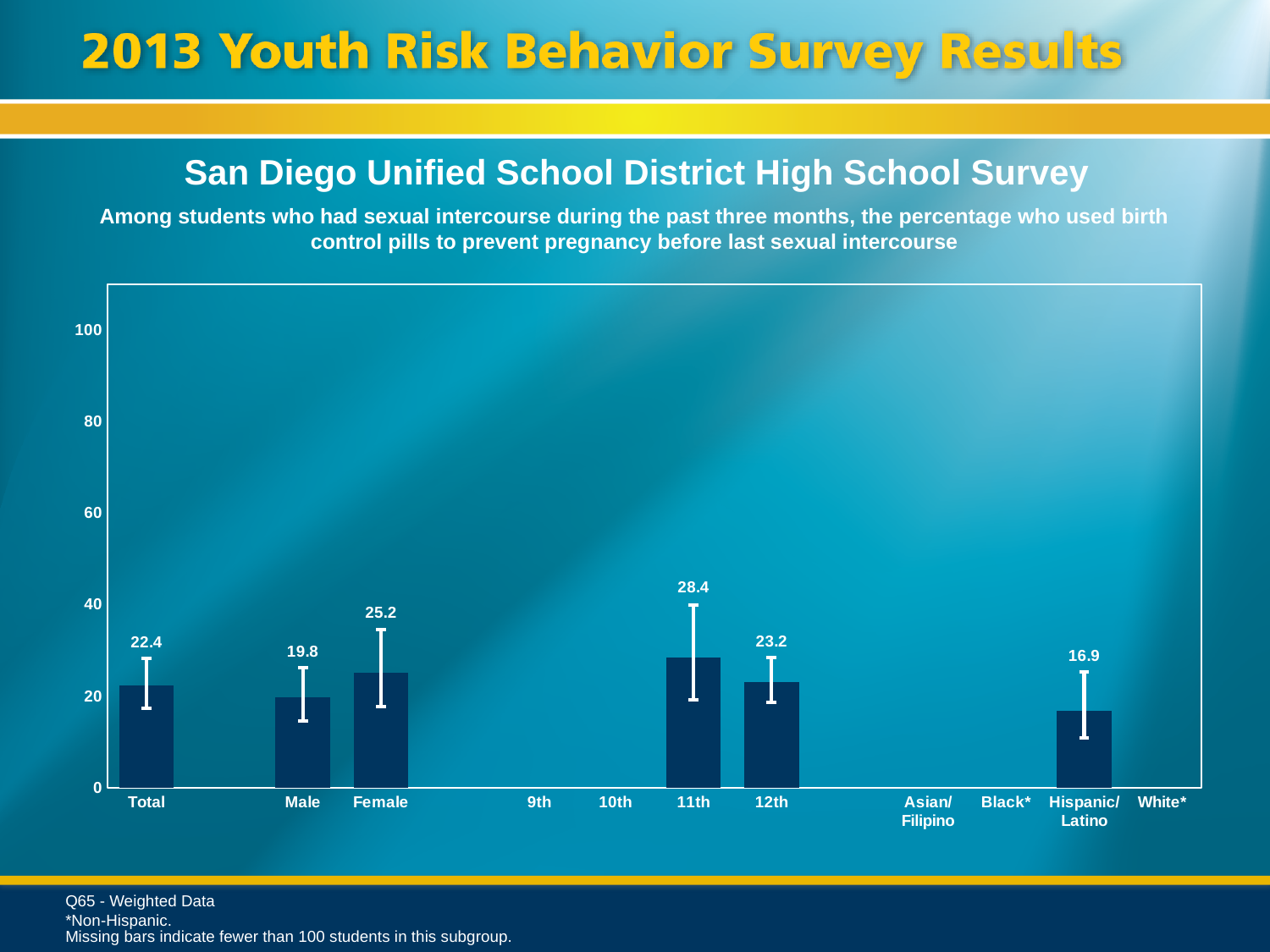
What does the footnote say missing bars indicate? Fewer than 100 students in this subgroup What is the value for 11th grade? 28.4 How many categories have a plotted bar? 6 What is the value for Female? 25.2 What is the value for Total? 22.4 Which category with a plotted bar has the lowest value? Hispanic/Latino What kind of chart is shown? bar chart What is the value for Hispanic/Latino? 16.9 What is the difference between the Female and Male values? 5.4 Which is larger, the value for 11th or the value for 12th? 11th Is the value for Male greater or less than 20? less Which category has the highest value? 11th